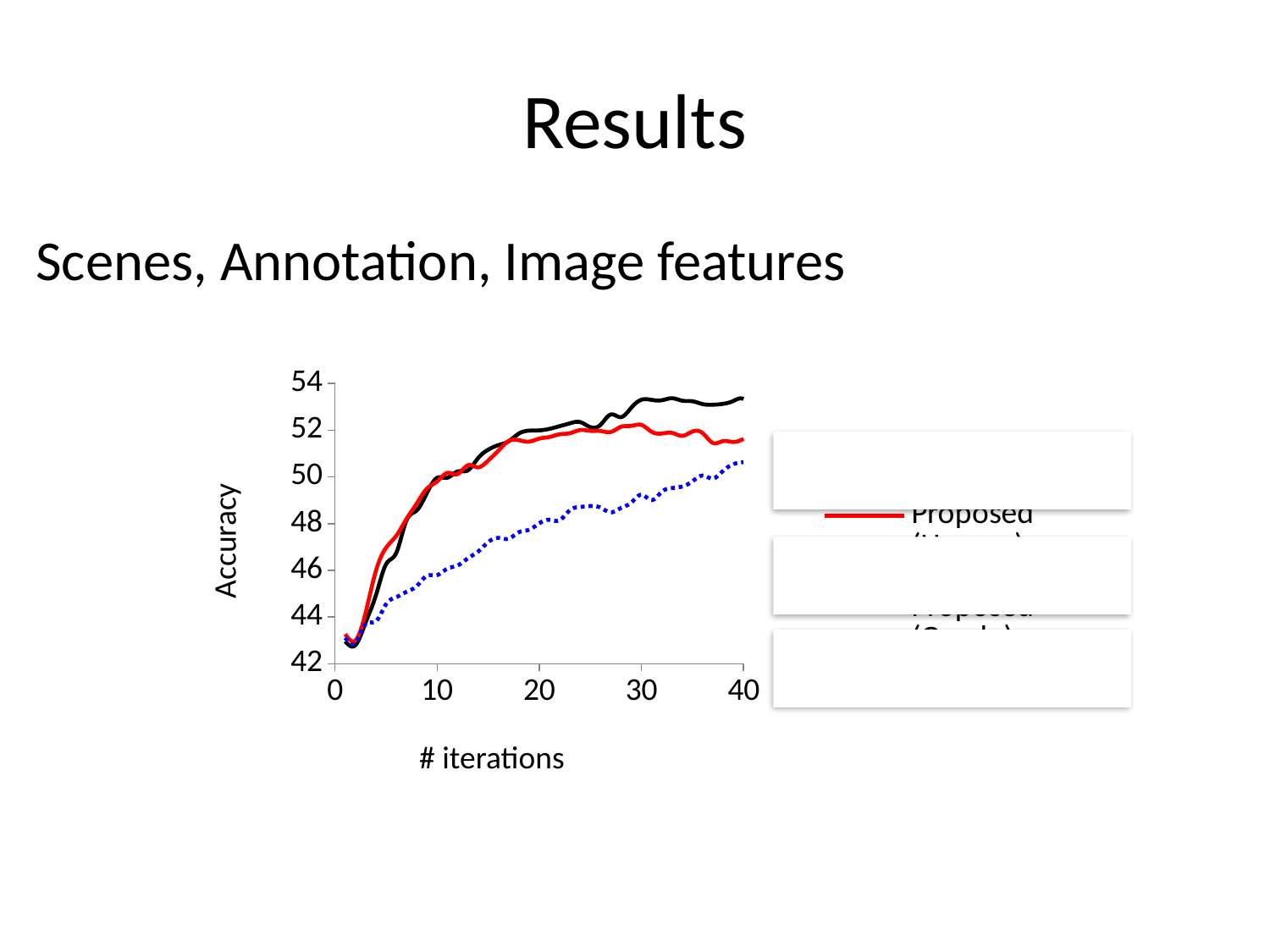
How many lines are plotted on the chart? 3 What is the label of the vertical axis of the chart? Accuracy Which line has the highest value at 30 iterations? black solid line At 10 iterations, is the value of the blue dotted line greater or less than 48? less Overall, does accuracy rise or fall as the number of iterations increases? rise At 20 iterations, is the value of the red solid line greater or less than 50? greater At 40 iterations, is the value of the red solid line greater or less than 50? greater Which line has the lowest value at 40 iterations? blue dotted line What is the label of the horizontal axis of the chart? # iterations What kind of chart is shown on the slide? line chart At 40 iterations, which line is higher, the black solid line or the blue dotted line? black solid line